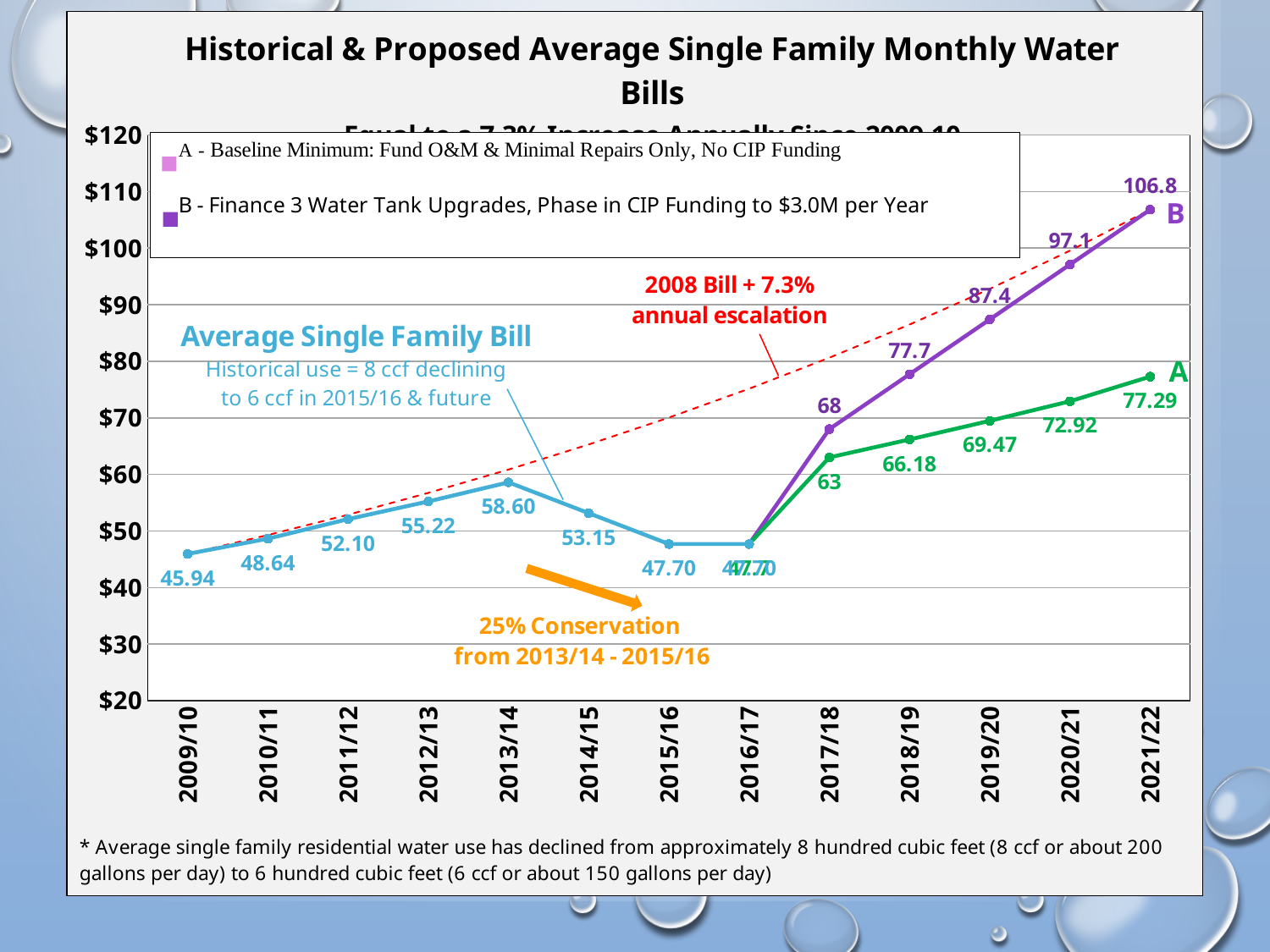
What is the value of line A in 2021/22? 77.29 What is the value of line B in 2018/19? 77.7 What type of chart is shown on the slide? Line chart In which year is the historical blue line at its lowest value? 2009/10 In which year does the historical blue line reach its highest value? 2013/14 In 2017/18, which is higher, line A or line B? B What is the average single family bill value shown for 2013/14? 58.60 How many fiscal years are shown on the x axis? 13 How many series does the legend list? 2 What is the value of line B in 2021/22? 106.8 How much did the average bill fall from 2013/14 to 2015/16? 10.90 What is the difference between line B and line A in 2021/22? 29.51